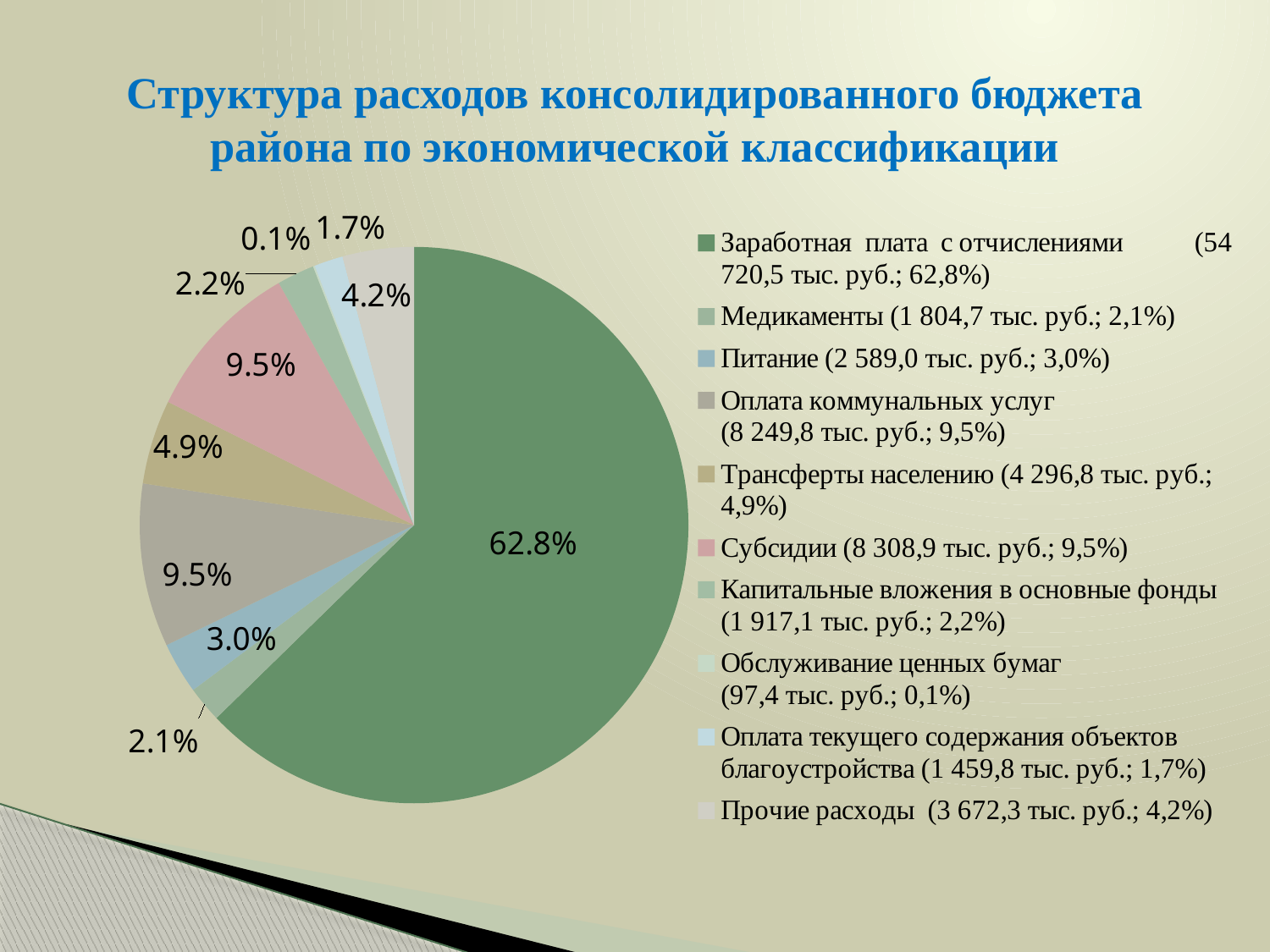
How many slices does the pie chart have? 10 Which two categories each have a 9.5% share of the pie? Оплата коммунальных услуг and Субсидии What colour is the largest slice of the pie? Green Which category has the largest slice of the pie? Заработная плата с отчислениями What share of the pie does "Прочие расходы" take? 4.2% By how many percentage points does the "Заработная плата с отчислениями" slice exceed the "Субсидии" slice? 53.3 percentage points Which slice is larger, "Питание" or "Медикаменты"? Питание What share of the pie does "Заработная плата с отчислениями" take? 62.8% According to the legend, what is the amount in thousand rubles for "Медикаменты"? 1 804,7 тыс. руб. What kind of chart is shown on the slide? Pie chart Which category has the smallest slice of the pie? Обслуживание ценных бумаг By how many percentage points does the "Питание" slice exceed the "Капитальные вложения в основные фонды" slice? 0.8 percentage points